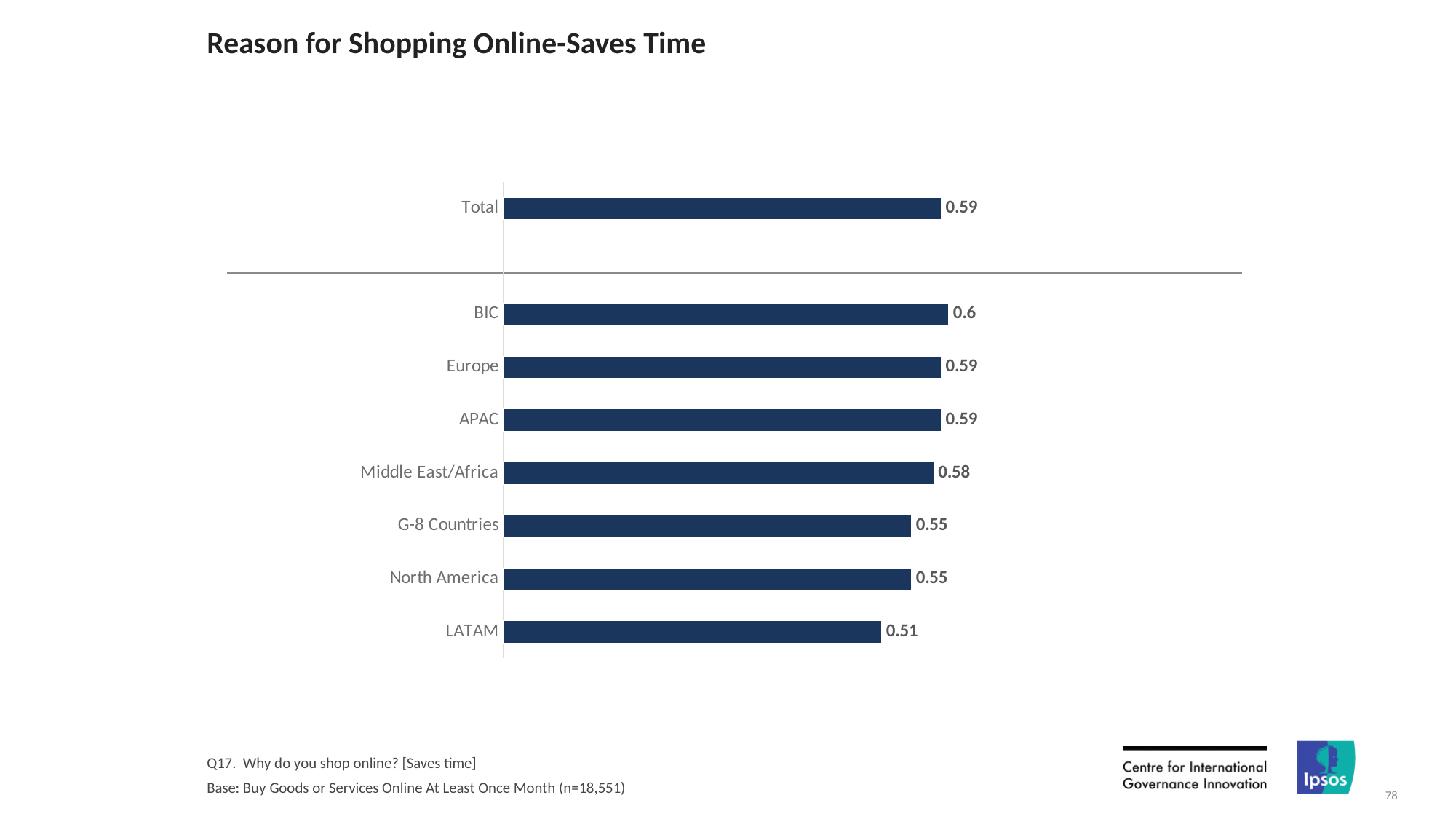
Which is larger, the value for APAC or the value for LATAM? APAC Which category has the lowest value? LATAM What is the difference between the values for BIC and LATAM? 0.09 What is the value for North America? 0.55 Which category has the highest value? BIC What kind of chart is shown on the slide? Bar chart What is the value for LATAM? 0.51 What is the value for BIC? 0.6 What is the difference between the values for Europe and G-8 Countries? 0.04 How many categories are shown in the chart? 8 What is the value for Middle East/Africa? 0.58 What is the value for Total? 0.59